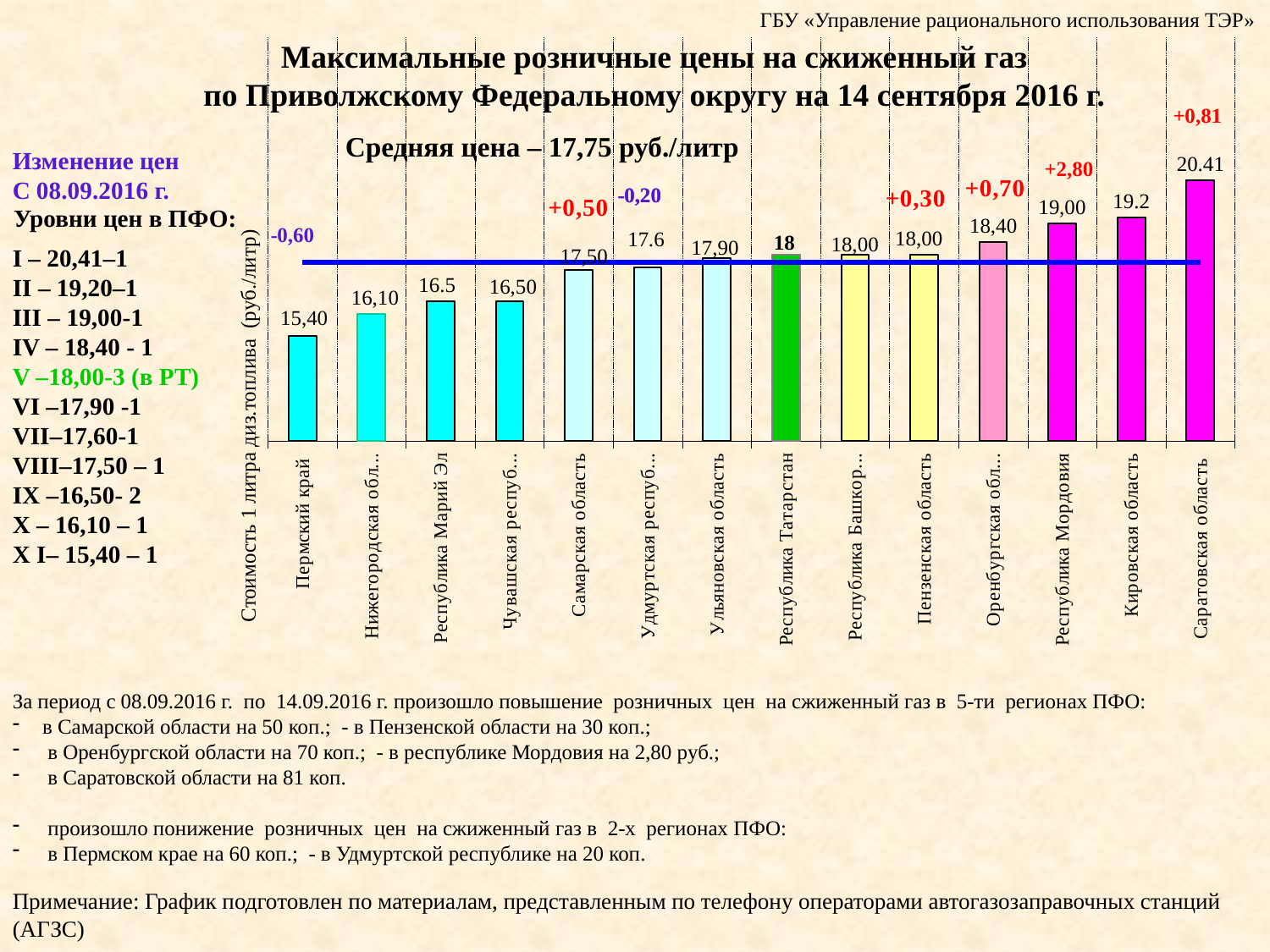
Which is larger, the value for Кировская область or the value for Ульяновская область? Кировская область Which region has the lowest value? Пермский край What is the value for Саратовская область? 20.41 Do the values generally rise or fall from left to right along the x axis? Rise What is the difference between the values for Республика Мордовия and Пермский край? 3,60 Which region has the highest value? Саратовская область How many regions are shown in the chart? 14 What is the value for Республика Татарстан? 18 What is the value for Пермский край? 15,40 What average price is stated above the chart? 17,75 руб./литр What is the value for Оренбургская обл...? 18,40 What kind of chart is shown on the slide? Bar chart